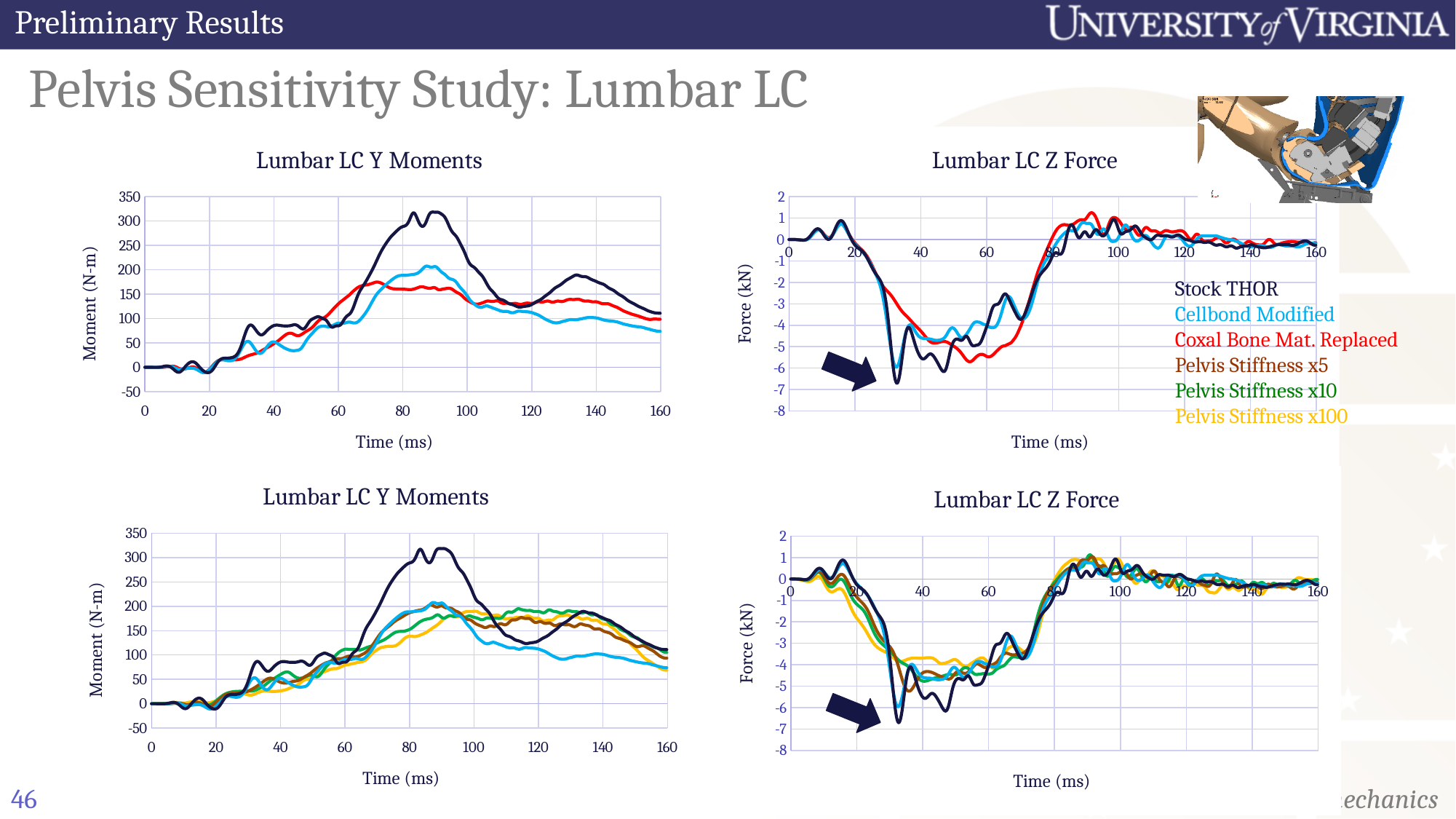
In the top-left "Lumbar LC Y Moments" chart, at 80 ms, which series has the larger moment: Stock THOR or Coxal Bone Mat. Replaced? Stock THOR What is the y-axis label on the "Lumbar LC Z Force" charts? Force (kN) How many series does the legend on the slide list? 6 In the bottom-right "Lumbar LC Z Force" chart, which series reaches the lowest force value? Stock THOR What is the x-axis label on the charts on this slide? Time (ms) In the bottom-left "Lumbar LC Y Moments" chart, is the value of the Stock THOR series at 90 ms greater or less than 300? greater In the top-right "Lumbar LC Z Force" chart, is the minimum value of the Stock THOR series greater or less than -6? less In the bottom-left "Lumbar LC Y Moments" chart, is the peak value of the Cellbond Modified series greater or less than 250? less In the top-right "Lumbar LC Z Force" chart, does the Stock THOR series rise or fall between 20 ms and 30 ms? fall What kind of chart is the top-left "Lumbar LC Y Moments" chart? line chart In the top-left "Lumbar LC Y Moments" chart, which series reaches the highest peak moment? Stock THOR